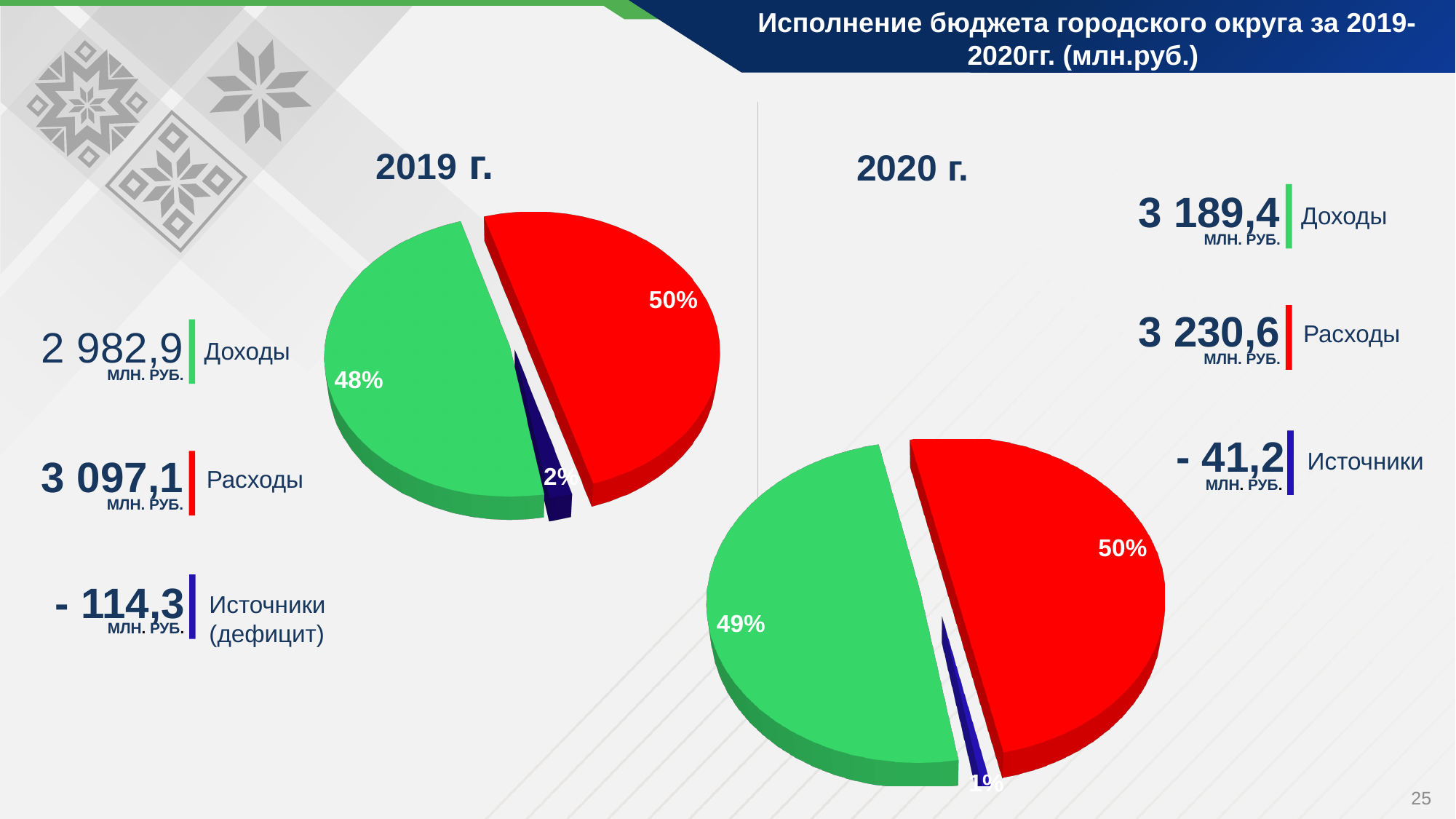
In the 2020 г. pie chart, what share does the green slice (Доходы) have? 49% In the 2019 г. pie chart, what share does the dark blue slice (Источники) have? 2% In the 2019 г. pie chart, what is the difference in percentage points between the red slice (50%) and the green slice (48%)? 2 In the 2020 г. pie chart, what share does the red slice (Расходы) have? 50% In the 2020 г. pie chart, which slice is the largest? Расходы What kind of chart is shown for 2019 г.? Pie chart How many slices does the 2020 г. pie chart have? 3 In the 2019 г. pie chart, which slice is the smallest? Источники (дефицит) Which colour represents Доходы in both pie charts? Green